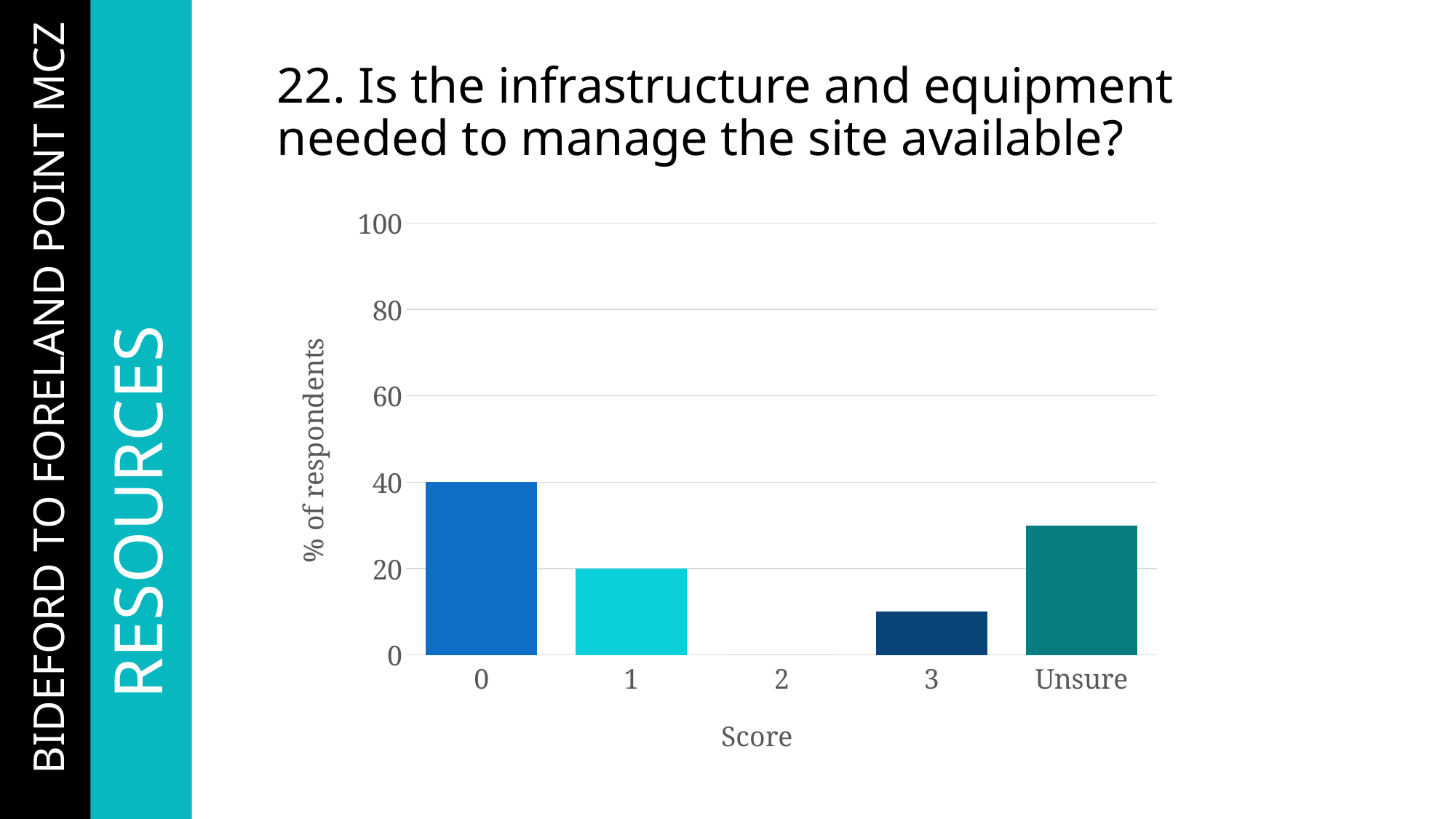
What percentage of respondents gave a score of 0? 40 What percentage of respondents gave a score of 2? 0 What is the difference in percentage of respondents between score 0 and score 1? 20 What percentage of respondents gave a score of 1? 20 What kind of chart is shown on the slide? bar chart Which has a higher percentage of respondents, score 1 or Unsure? Unsure What is the label of the y axis? % of respondents Is the value for Unsure greater or less than 20? greater Which score category has the highest percentage of respondents? 0 Is the value for score 3 greater or less than 20? less Which score category has the lowest percentage of respondents? 2 How many score categories are shown on the x axis? 5